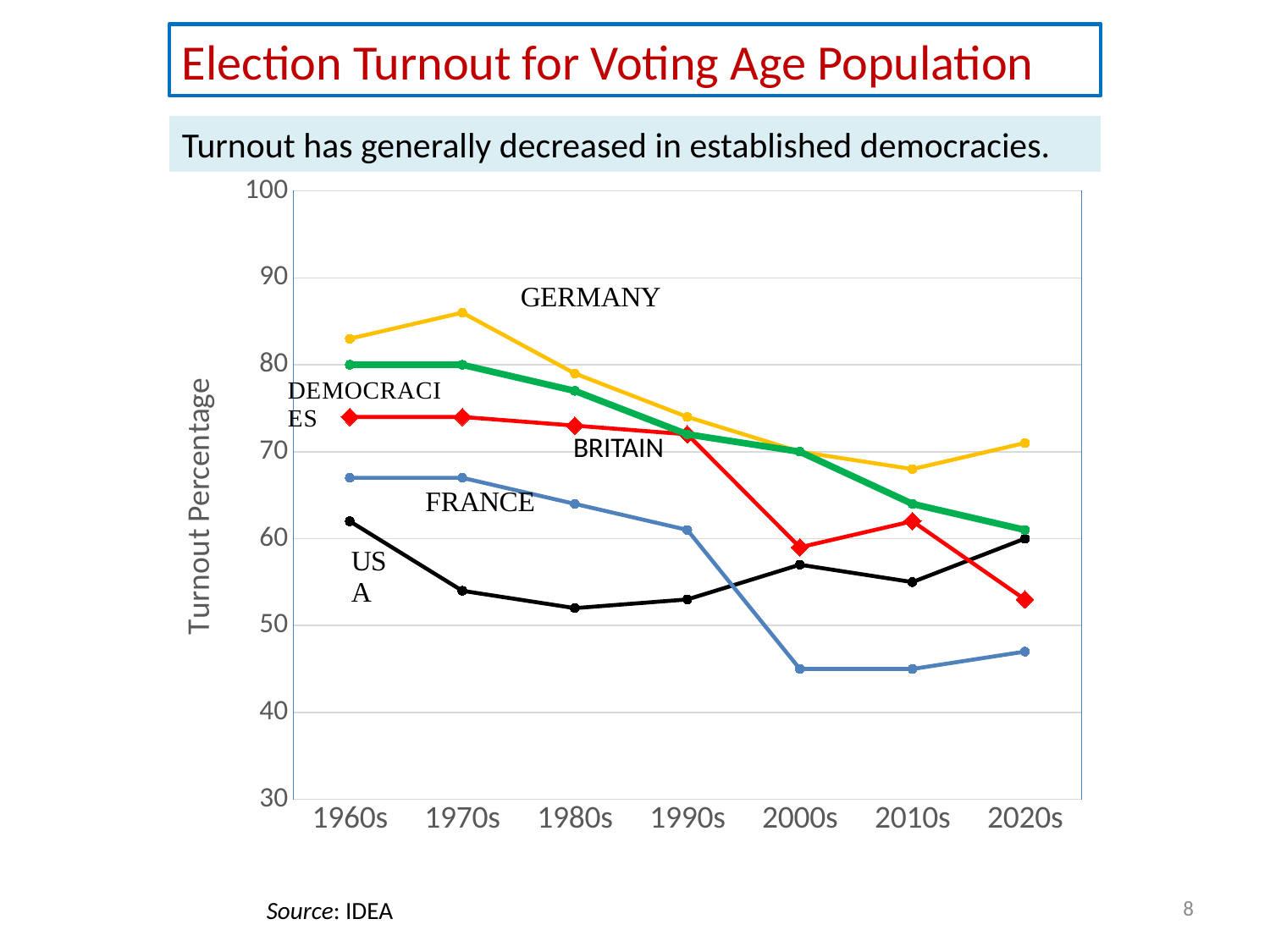
How many decades are shown along the x axis of the chart? 7 In the 1960s, which has the higher turnout, BRITAIN or FRANCE? BRITAIN Does the turnout for FRANCE generally rise or fall from the 1960s to the 2020s? fall In the 2020s, which has the higher turnout, BRITAIN or USA? USA What kind of chart is shown on the slide? line chart Is the value for GERMANY in the 1970s greater or less than 80? greater Is the value for USA in the 1980s greater or less than 60? less How many lines (series) are plotted on the chart? 5 Which series has the highest turnout in the 1960s? GERMANY Which series has the lowest turnout in the 2000s? FRANCE Is the value for FRANCE in the 2000s greater or less than 50? less What is the title of the y axis? Turnout Percentage